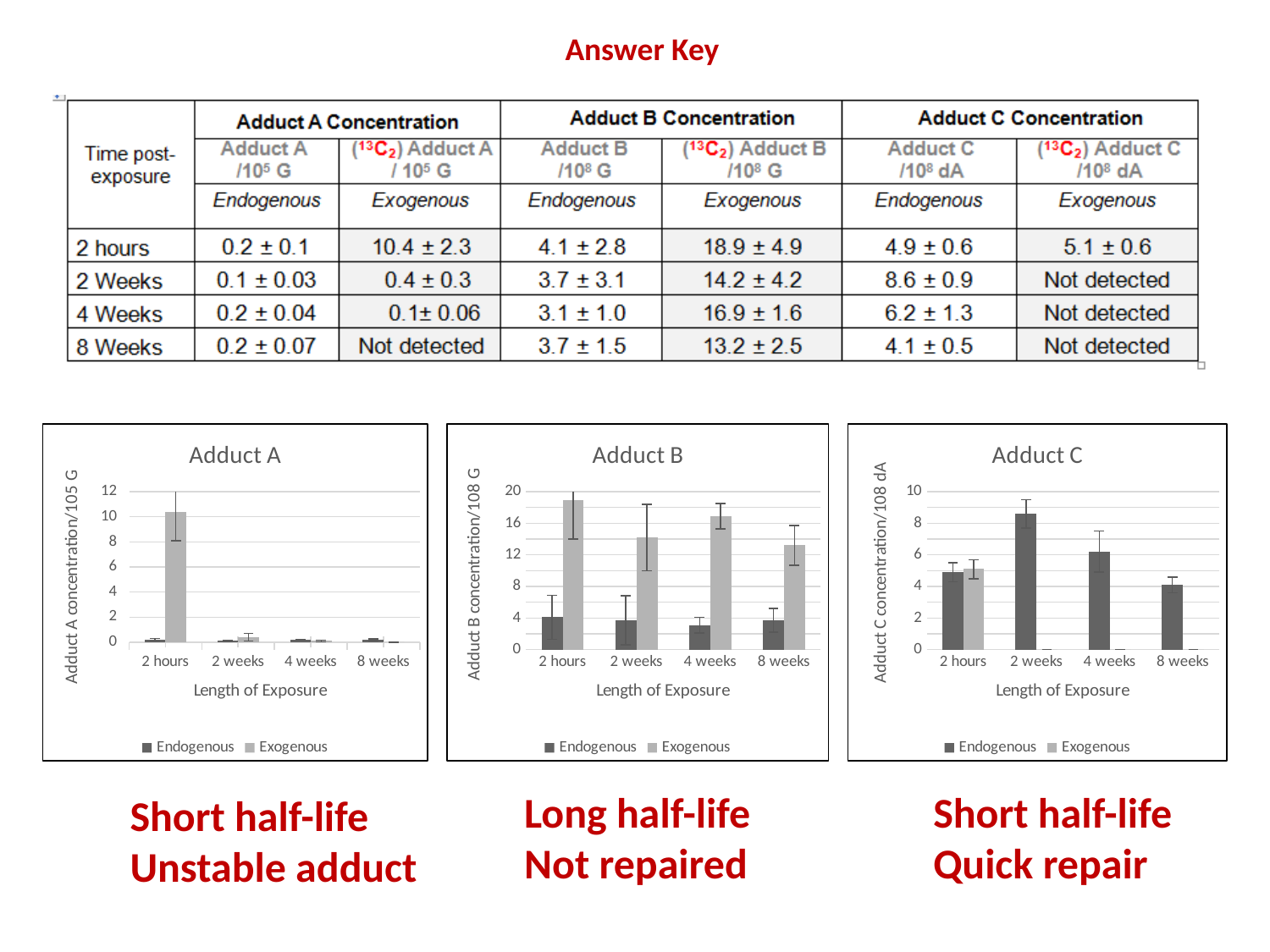
In the Adduct A chart, is the Exogenous value at 2 hours greater or less than 8? greater In the Adduct B chart, is the Exogenous value at 2 hours greater or less than 16? greater In the Adduct A chart, which category has the highest Exogenous bar? 2 hours In the Adduct C chart, is the Endogenous value at 8 weeks greater or less than 6? less In the Adduct C chart, which category has the highest Endogenous bar? 2 weeks In the Adduct B chart, at 2 hours, which is larger: Endogenous or Exogenous? Exogenous In the Adduct C chart, do the Endogenous values rise or fall from 2 weeks to 8 weeks? fall In the Adduct B chart, how many series does the legend list? 2 In the Adduct C chart, how many categories are shown on the x axis? 4 What is the x-axis title of the Adduct B chart? Length of Exposure What kind of chart is the Adduct A chart? bar chart